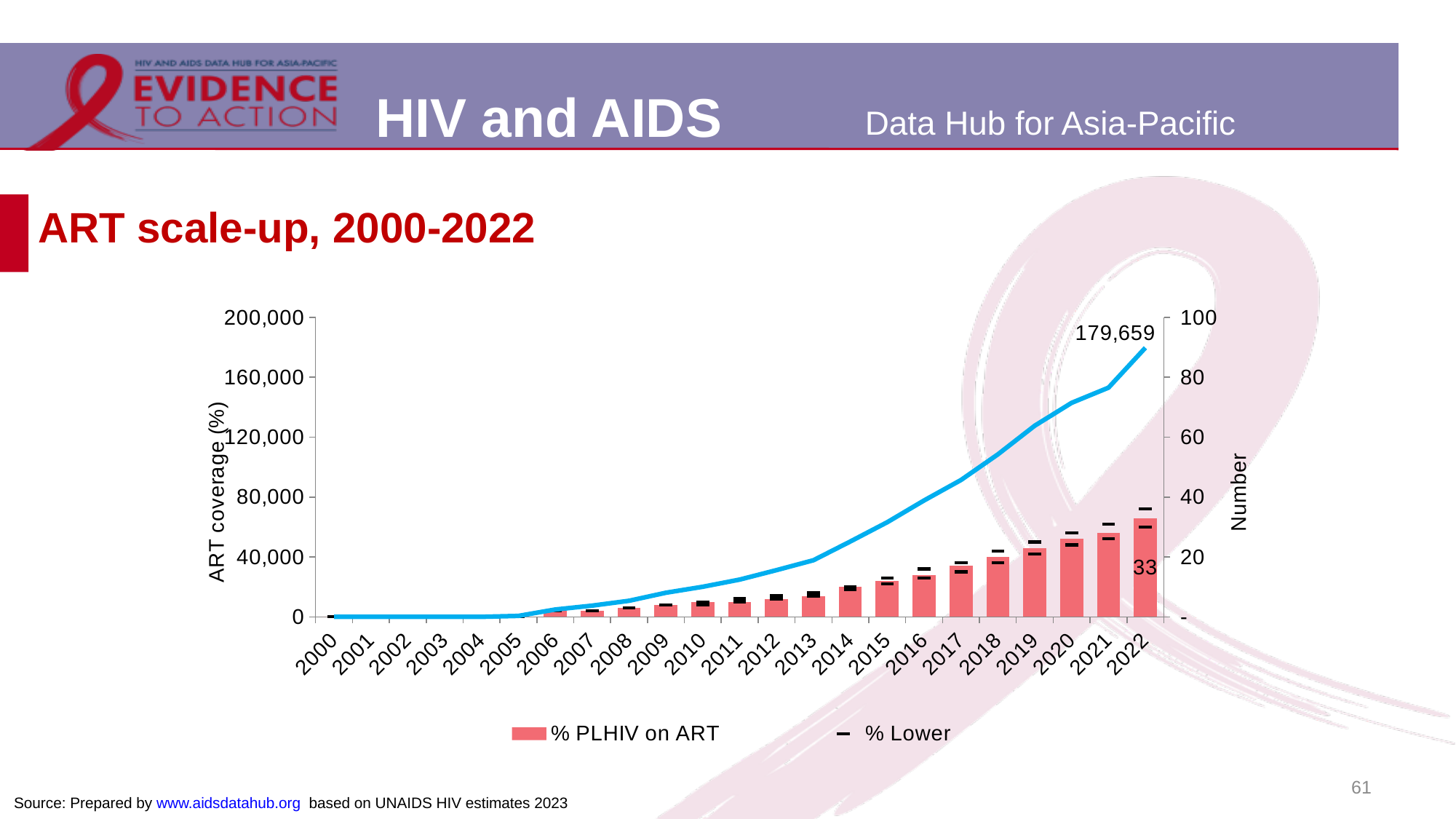
Is the value of the blue line in 2022 greater or less than 160,000? greater How many years are shown on the x axis? 23 Does the blue line rise or fall from 2000 to 2022? rises Is the bar for 2015 greater or less than 20 on the right-hand axis? less How many entries does the legend list? 2 What is the data label shown at the end of the blue line for 2022? 179,659 What kind of chart is this? combined bar and line chart What is the data label shown on the bar for 2022? 33 Which year has the tallest bar? 2022 Which bar is taller, 2010 or 2022? 2022 Is the value of the blue line in 2010 greater or less than 40,000? less What is the title of the chart? ART scale-up, 2000-2022